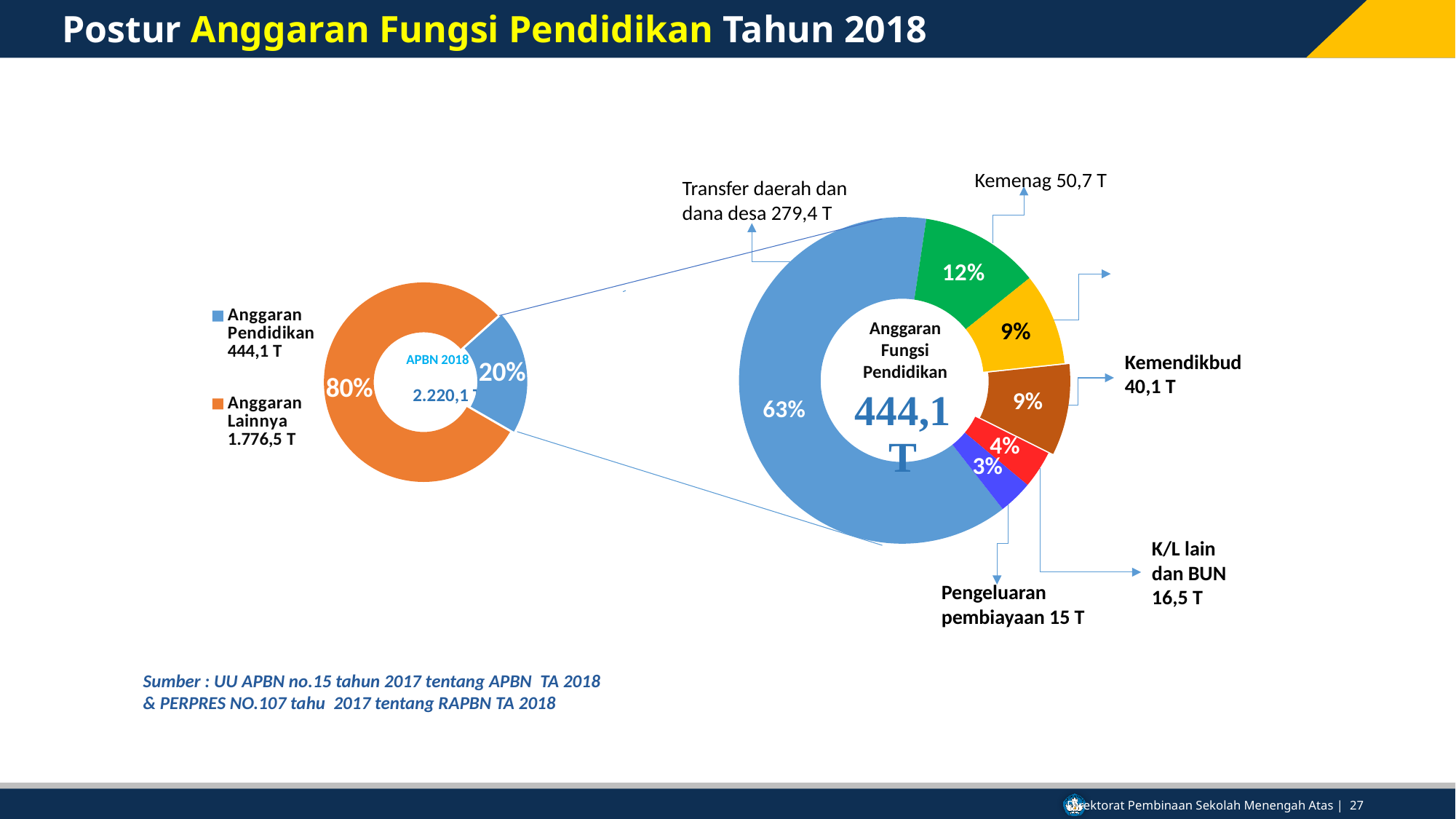
In the left APBN 2018 chart, what share of the total does Anggaran Pendidikan represent? 20% In the left APBN 2018 chart, how many categories are shown? 2 In the right Anggaran Fungsi Pendidikan chart, which is larger: Kemenag or K/L lain dan BUN? Kemenag In the left APBN 2018 chart, what is the value for Anggaran Lainnya? 1.776,5 T In the right Anggaran Fungsi Pendidikan chart, what is the difference between Kemenag (50,7 T) and Kemendikbud (40,1 T)? 10,6 T In the left APBN 2018 chart, what is the value for Anggaran Pendidikan? 444,1 T In the right Anggaran Fungsi Pendidikan chart, which category has the largest share? Transfer daerah dan dana desa In the right Anggaran Fungsi Pendidikan chart, what share does Transfer daerah dan dana desa represent? 63% In the left APBN 2018 chart, what share of the total does Anggaran Lainnya represent? 80% What kind of chart is the left chart labelled APBN 2018? Donut (pie) chart In the right Anggaran Fungsi Pendidikan chart, what is the value for Kemenag? 50,7 T In the right Anggaran Fungsi Pendidikan chart, what is the value for Transfer daerah dan dana desa? 279,4 T